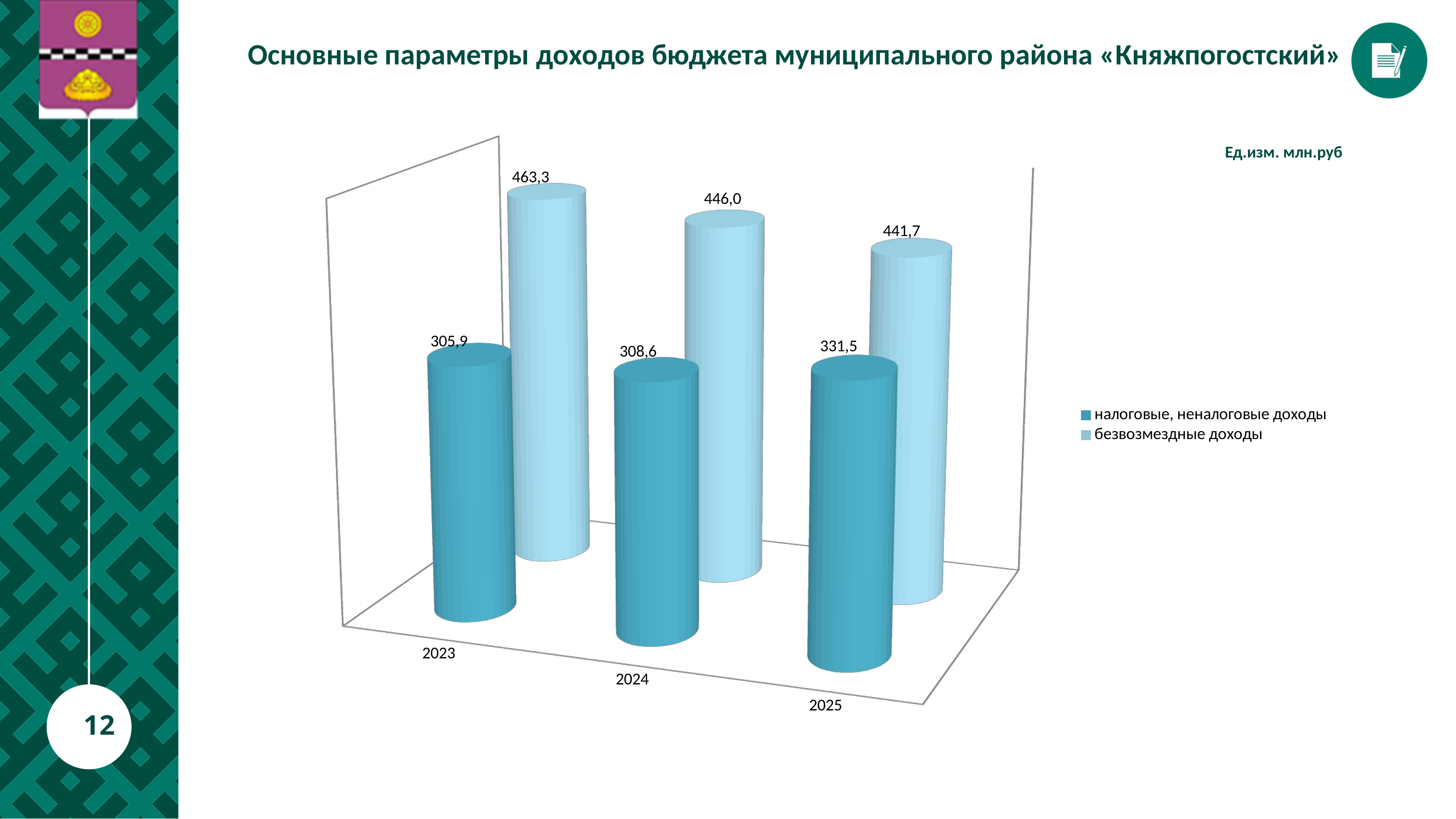
What is the value for безвозмездные доходы in 2024? 446,0 What is the difference between безвозмездные доходы and налоговые, неналоговые доходы in 2025? 110,2 In which year is налоговые, неналоговые доходы lowest? 2023 How many series does the legend list? 2 Do the values for безвозмездные доходы rise or fall from 2023 to 2025? fall By how much did налоговые, неналоговые доходы change from 2023 to 2025? 25,6 In which year is безвозмездные доходы highest? 2023 Which is larger in 2024: налоговые, неналоговые доходы or безвозмездные доходы? безвозмездные доходы How many years are shown on the x axis? 3 What kind of chart is shown on the slide? bar chart What is the value for налоговые, неналоговые доходы in 2023? 305,9 What is the value for безвозмездные доходы in 2025? 441,7